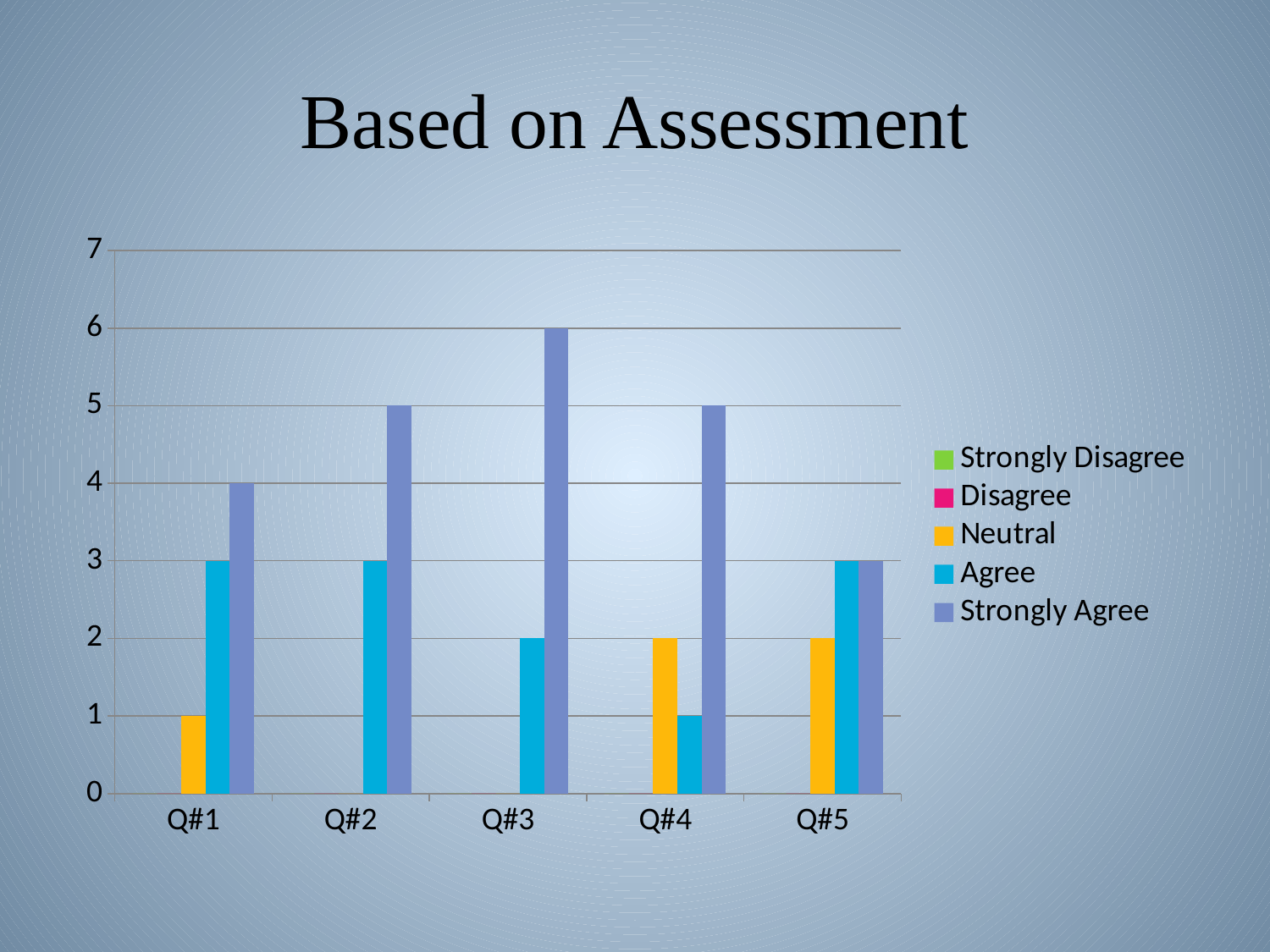
Is the Strongly Agree value for Q#4 greater or less than 4? greater Which question has the highest Strongly Agree value? Q#3 What is the Strongly Agree value for Q#3? 6 What is the Neutral value for Q#4? 2 Which question has the lowest Agree value? Q#4 Which is larger for Q#2: the Agree value or the Strongly Agree value? Strongly Agree What kind of chart is shown on the slide? Bar chart What is the title of the chart? Based on Assessment What is the difference between the Strongly Agree values for Q#3 and Q#1? 2 What is the Agree value for Q#1? 3 How many question categories are shown on the x axis? 5 How many series does the legend list? 5